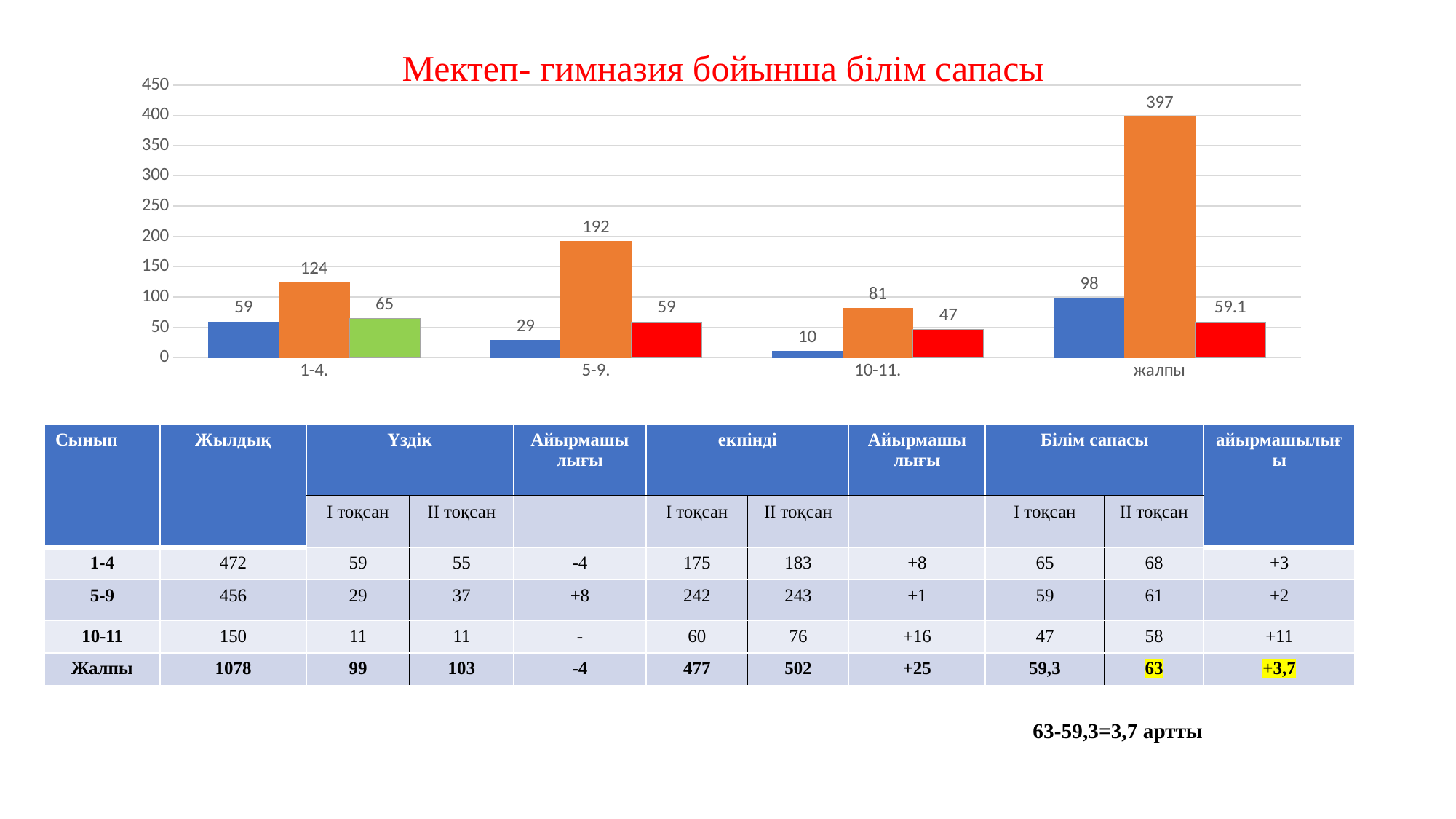
Which is larger: the blue bar for '1-4.' or the blue bar for '5-9.'? 1-4. Which category has the lowest blue bar? 10-11. How many categories are shown on the x axis of the chart? 4 Is the value of the orange bar for '10-11.' greater or less than 100? less What is the difference between the orange bar values for '5-9.' and '1-4.'? 68 Which category has the highest orange bar? жалпы What type of chart is shown on the slide? bar chart What is the value of the red bar for the '10-11.' category? 47 What is the value of the blue bar for the '5-9.' category? 29 What is the title of the chart? Мектеп- гимназия бойынша білім сапасы What is the value of the green bar for the '1-4.' category? 65 What is the value of the orange bar for the 'жалпы' category? 397